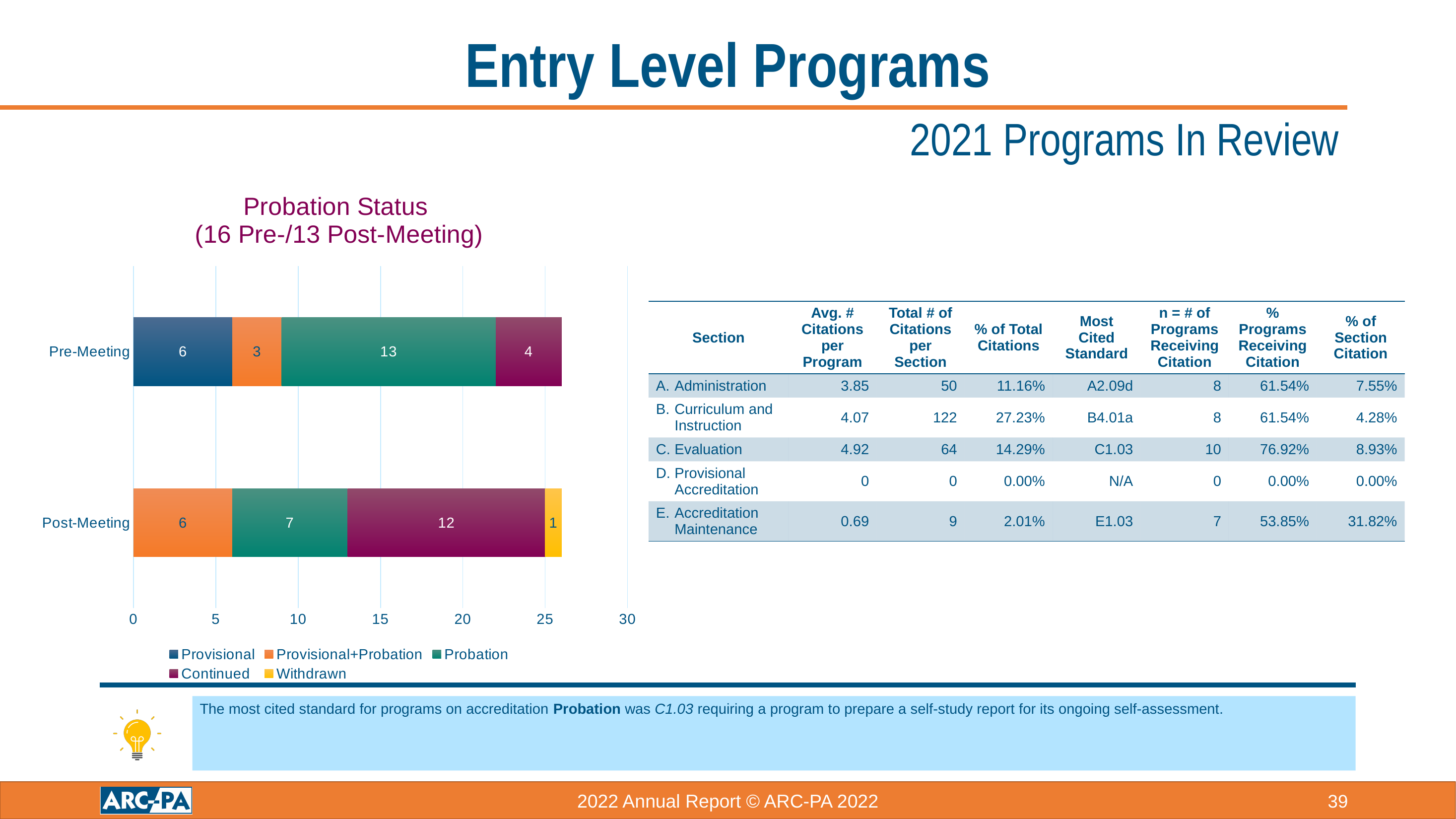
In the Probation Status chart, what is the Continued value for Post-Meeting? 12 In the Probation Status chart, what is the difference between the Probation values for Pre-Meeting and Post-Meeting? 6 How many categories are shown on the y axis of the Probation Status chart? 2 In the Probation Status chart, which is larger: the Continued value for Pre-Meeting or for Post-Meeting? Post-Meeting In the Probation Status chart, what is the Provisional+Probation value for Pre-Meeting? 3 In the Probation Status chart, what is the total of the stacked bar for Pre-Meeting? 26 In the Probation Status chart, what is the Probation value for Pre-Meeting? 13 In the Probation Status chart, what is the Withdrawn value for Post-Meeting? 1 In the Probation Status chart, what is the Provisional value for Pre-Meeting? 6 What kind of chart is the Probation Status chart? bar chart In the Probation Status chart, which series has the largest segment in the Post-Meeting bar? Continued How many series does the legend of the Probation Status chart list? 5